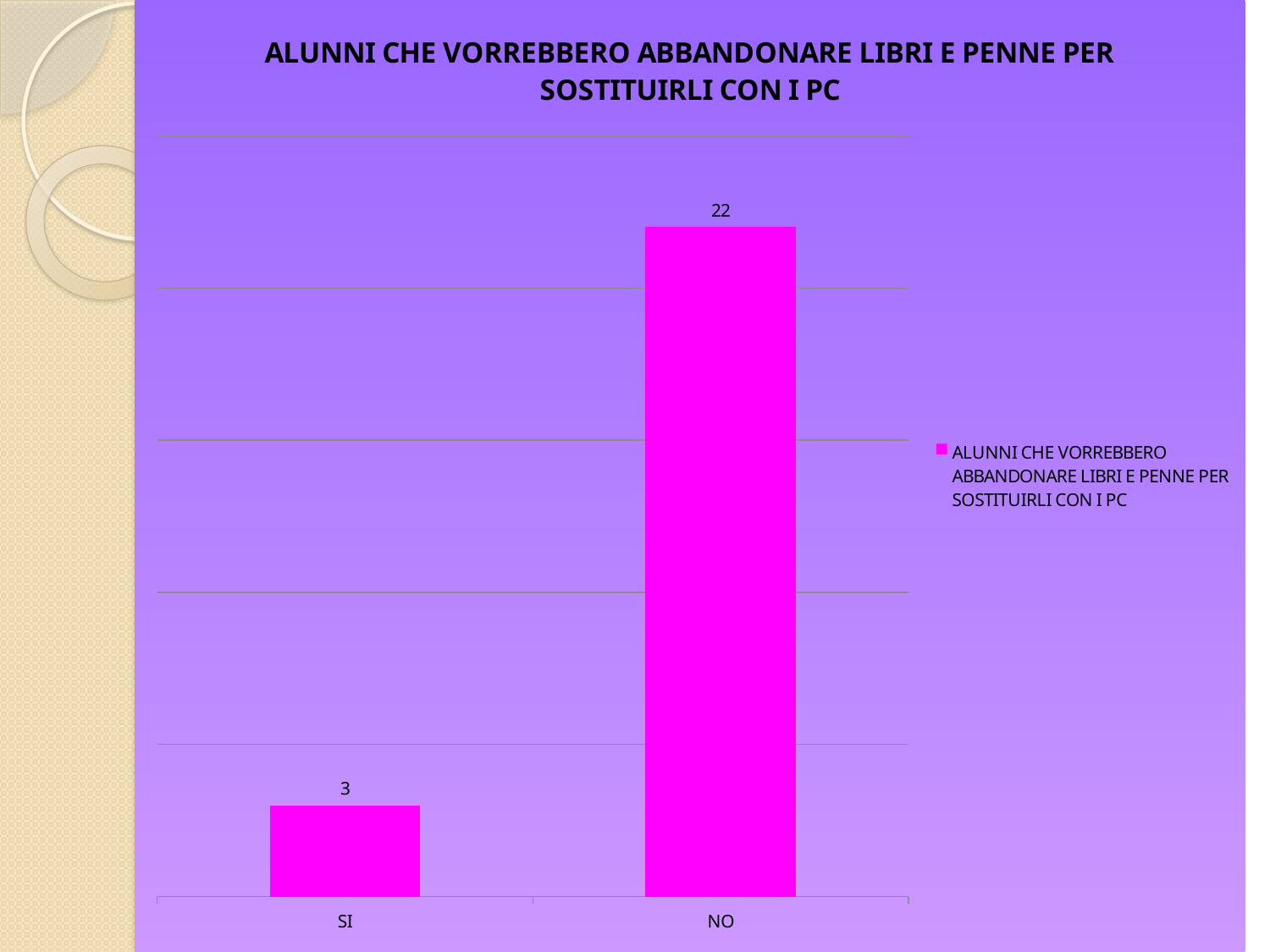
What is the value for SI? 3 Which category has the highest value? NO What kind of chart is shown on the slide? bar chart What is the difference between the values for NO and SI? 19 What colour are the bars in the chart? magenta What is the total of the values for SI and NO? 25 What is the title of the chart? ALUNNI CHE VORREBBERO ABBANDONARE LIBRI E PENNE PER SOSTITUIRLI CON I PC Which is larger, the value for SI or the value for NO? NO What is the value for NO? 22 How many series does the legend list? 1 How many categories are shown on the x axis? 2 Which category has the lowest value? SI